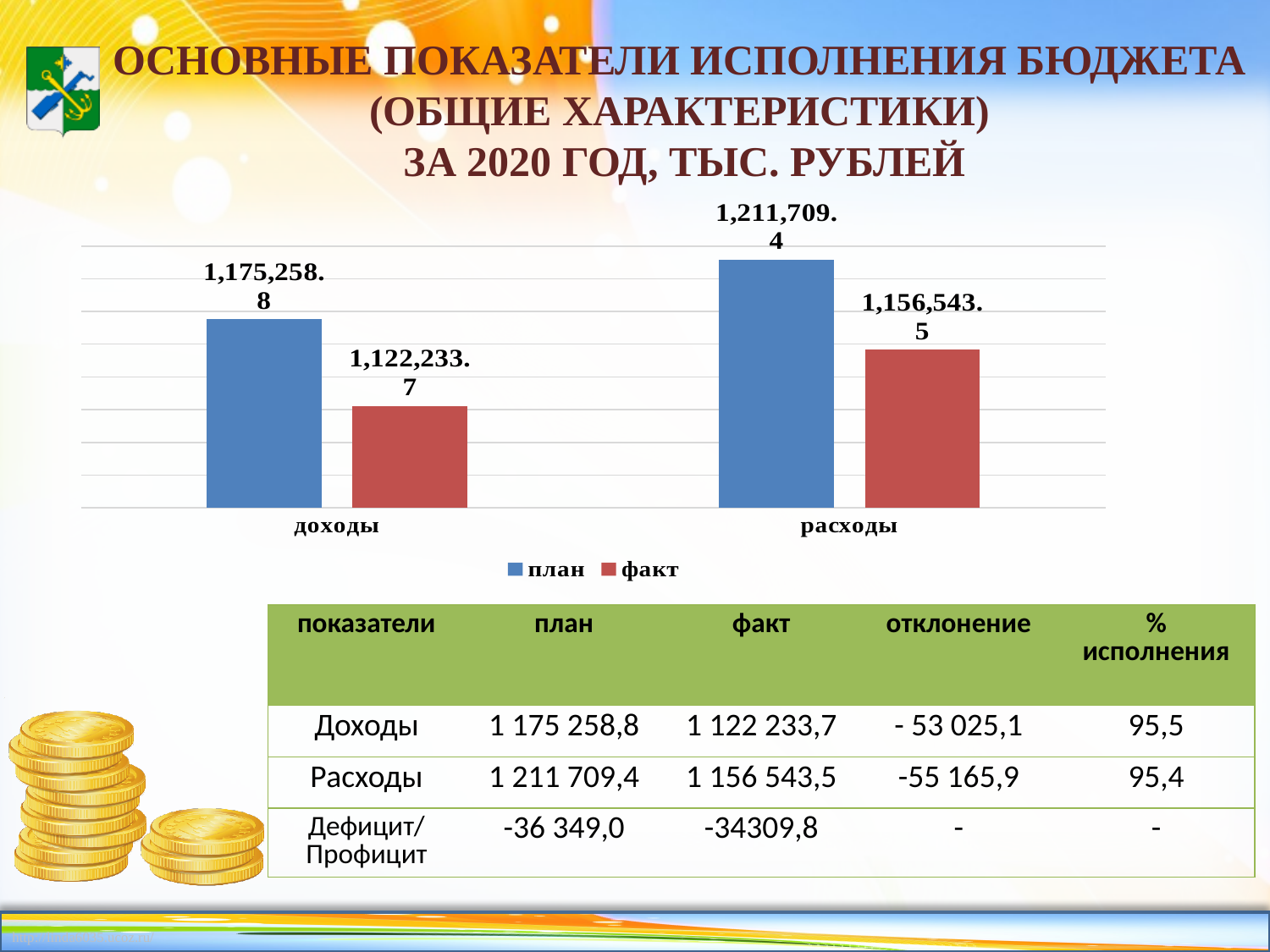
Which bar in the chart has the lowest value? факт for доходы Which bar in the chart has the highest value? план for расходы What type of chart is shown on the slide? bar chart What is the факт value for доходы in the chart? 1,122,233.7 What is the difference between the план and факт values for расходы? 55,165.9 What is the факт value for расходы in the chart? 1,156,543.5 What is the план value for доходы in the chart? 1,175,258.8 What is the план value for расходы in the chart? 1,211,709.4 Which is larger: the факт value for доходы or the факт value for расходы? факт for расходы How many categories are shown on the x axis of the chart? 2 How many series does the chart legend list? 2 What is the difference between the план and факт values for доходы? 53,025.1